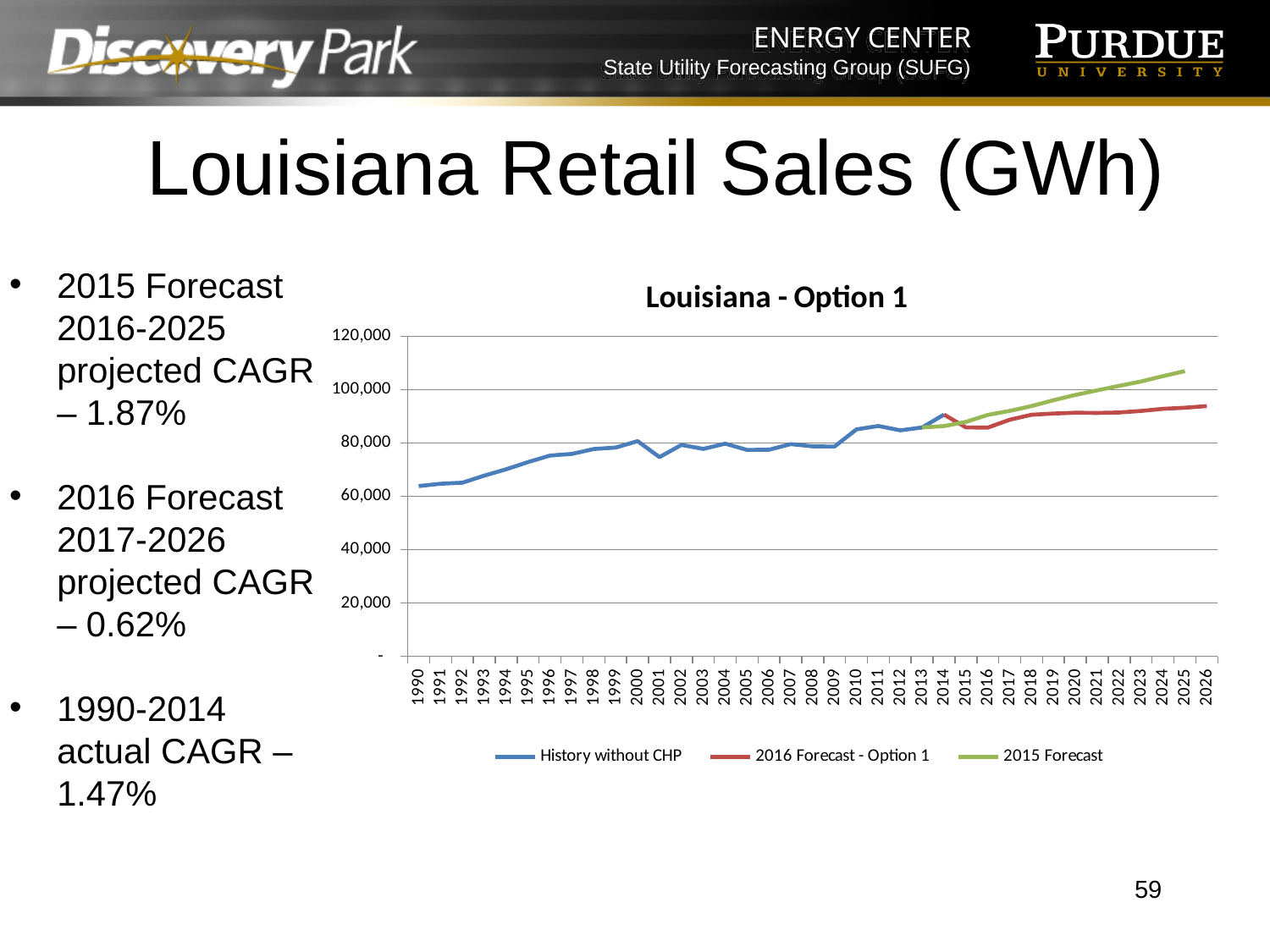
Is the value for History without CHP in 2010 greater or less than 80,000? greater What is the title of the chart? Louisiana - Option 1 How many years are shown on the x axis of the chart? 37 Is the value for History without CHP in 1990 greater or less than 80,000? less Does the 2015 Forecast series rise or fall from 2014 to 2025? Rise Is the value for the 2015 Forecast in 2025 greater or less than 100,000? greater Which series is drawn in green in the chart? 2015 Forecast How many series does the chart legend list? 3 What kind of chart is shown on the slide? Line chart In 2025, which series has the higher value: 2015 Forecast or 2016 Forecast - Option 1? 2015 Forecast In which year does the History without CHP series have its lowest value? 1990